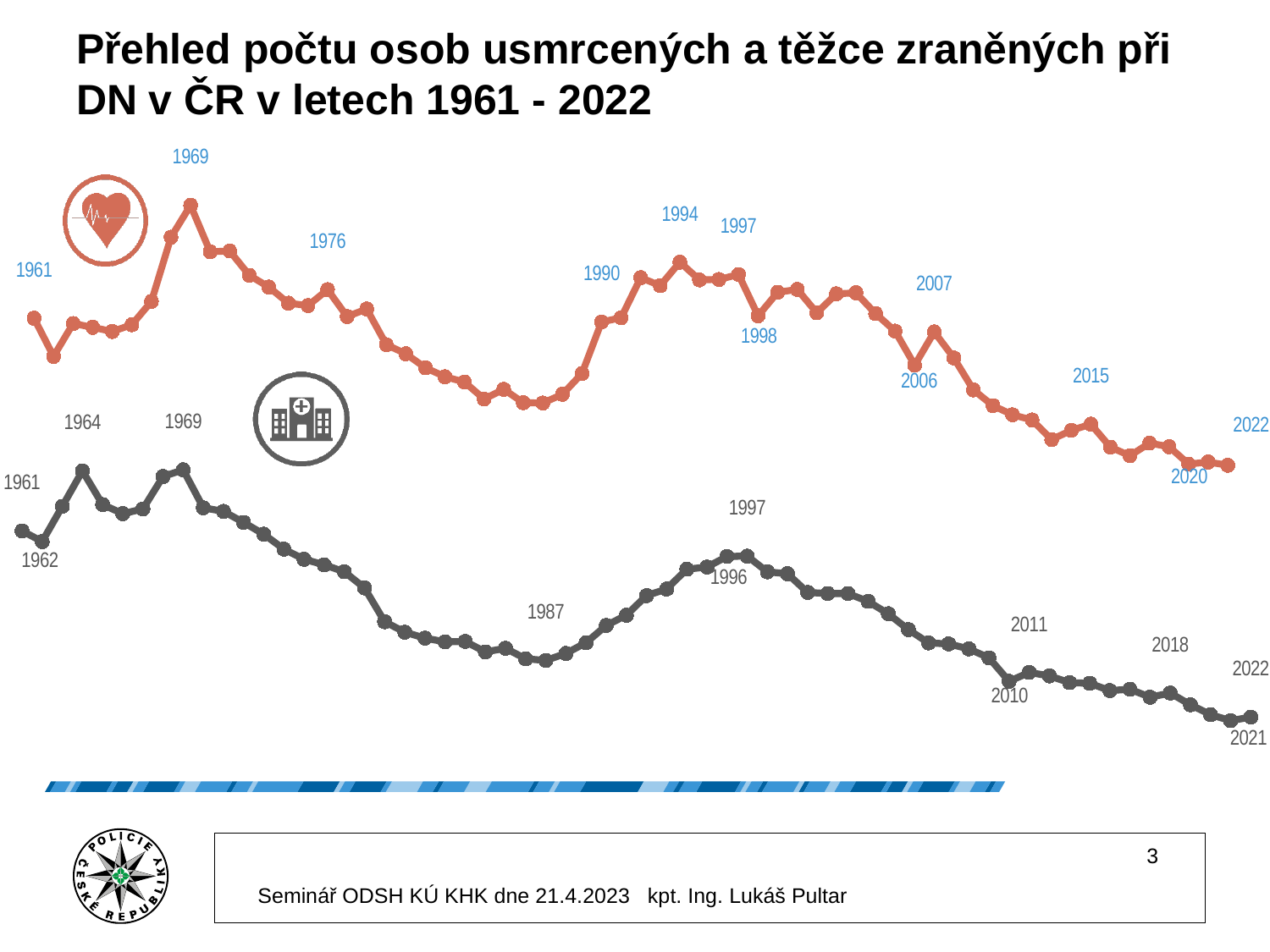
Does the upper (red) line rise or fall between 2007 and 2020? falls On the lower (grey) line, is the value for 1964 higher or lower than the value for 1962? higher What is the title of the chart on the slide? Přehled počtu osob usmrcených a těžce zraněných při DN v ČR v letech 1961 - 2022 In which labelled year does the lower (grey) line reach its lowest point? 2021 Does the upper (red) line rise or fall between 1990 and 1994? rises On the upper (red) line, is the value for 1997 higher or lower than the value for 1998? higher On the lower (grey) line, is the value for 1997 higher or lower than the value for 2010? higher How many lines are plotted on the chart? 2 What kind of chart is shown on the slide? line chart Does the lower (grey) line rise or fall between 1987 and 1997? rises In which labelled year does the upper (red) line reach its highest point? 1969